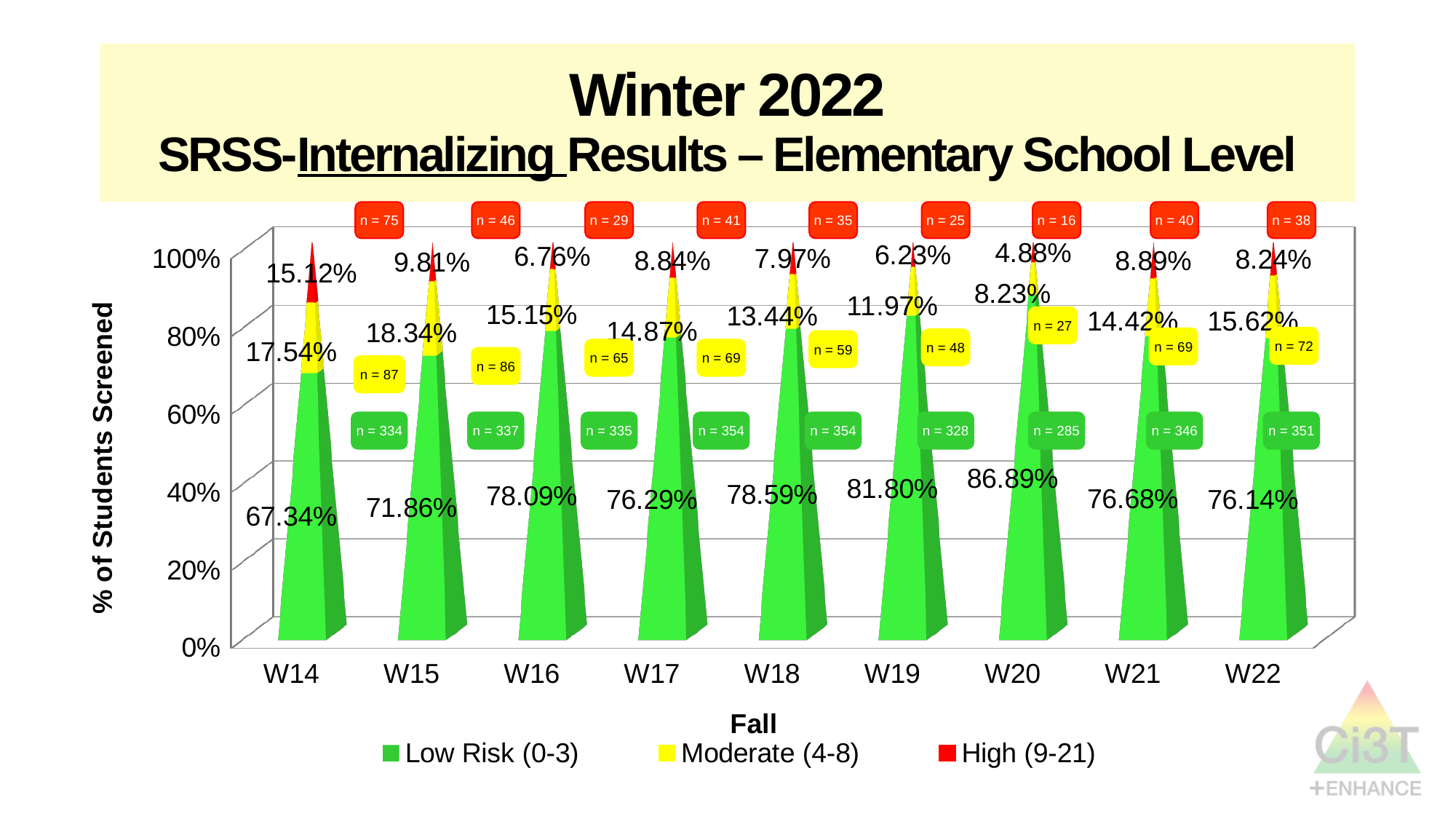
What is the difference between the Low Risk (0-3) percentages for W20 and W14? 19.55% What kind of chart is shown on the slide? Stacked bar chart What is the Low Risk (0-3) percentage for W14? 67.34% What is the title of the x axis? Fall Which has a larger Moderate (4-8) percentage, W15 or W19? W15 How many series does the legend list? 3 What is the High (9-21) percentage for W20? 4.88% Which category has the highest High (9-21) percentage? W14 Which category has the highest Low Risk (0-3) percentage? W20 What is the Moderate (4-8) percentage for W18? 13.44% How many categories are shown on the x axis? 9 Which category has the lowest Low Risk (0-3) percentage? W14